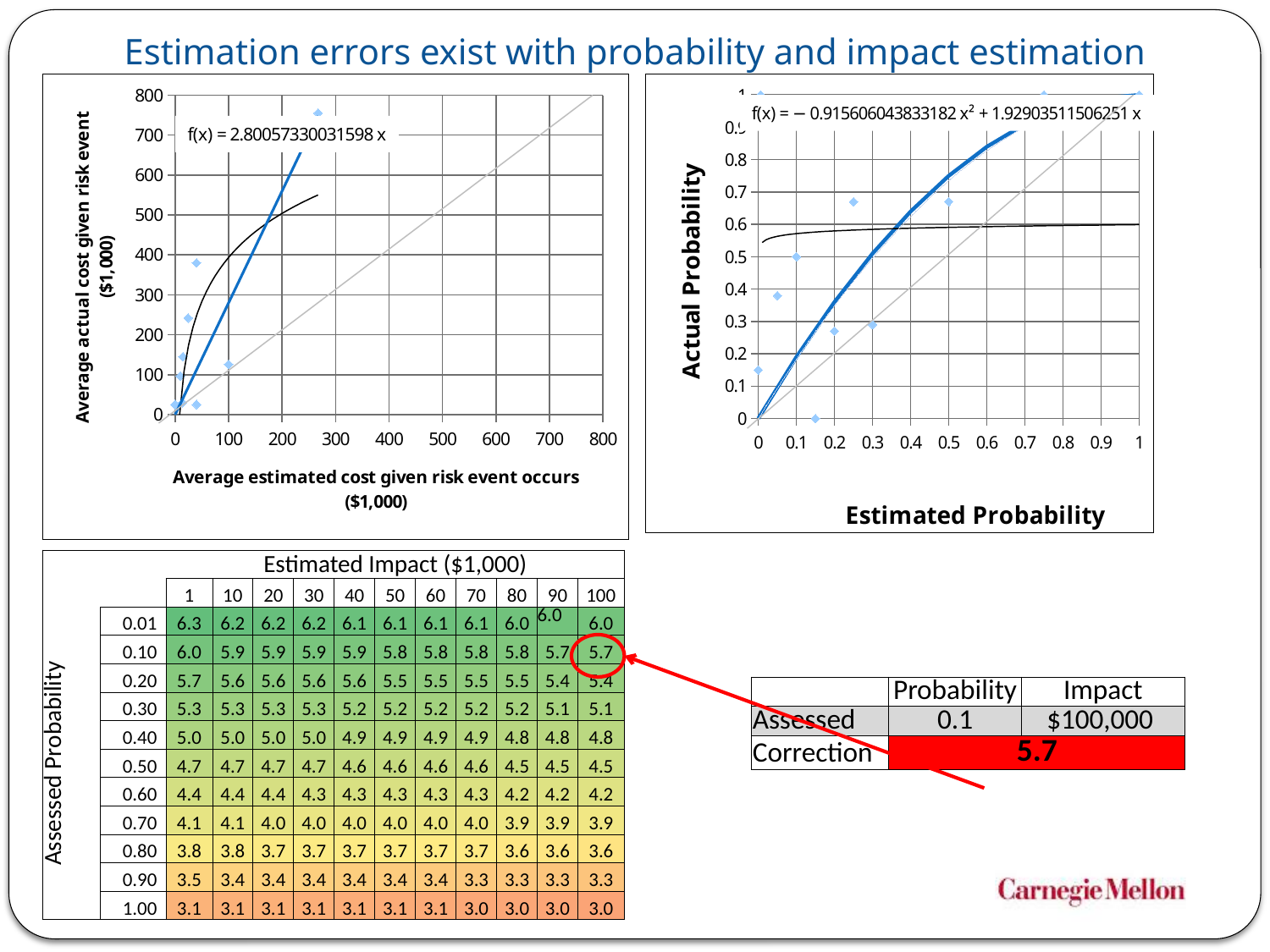
On the left chart, does the blue trendline rise or fall as estimated cost increases? rise On the right chart, what is the title of the y axis? Actual Probability On the left chart, is the actual cost for the point with the highest estimated cost greater or less than 700? greater On the right chart, what is the trendline equation shown? f(x) = − 0.915606043833182 x² + 1.92903511506251 x On the right chart, is the actual probability for the point at an estimated probability of 0.3 greater or less than 0.4? less What kind of chart is the right chart (Actual Probability vs Estimated Probability)? scatter chart On the left chart, what is the title of the x axis? Average estimated cost given risk event occurs ($1,000) On the right chart, is the actual probability for the point at an estimated probability of 0.1 greater or less than 0.4? greater On the left chart, what is the trendline equation shown? f(x) = 2.80057330031598 x What kind of chart is the left chart (actual cost vs estimated cost)? scatter chart